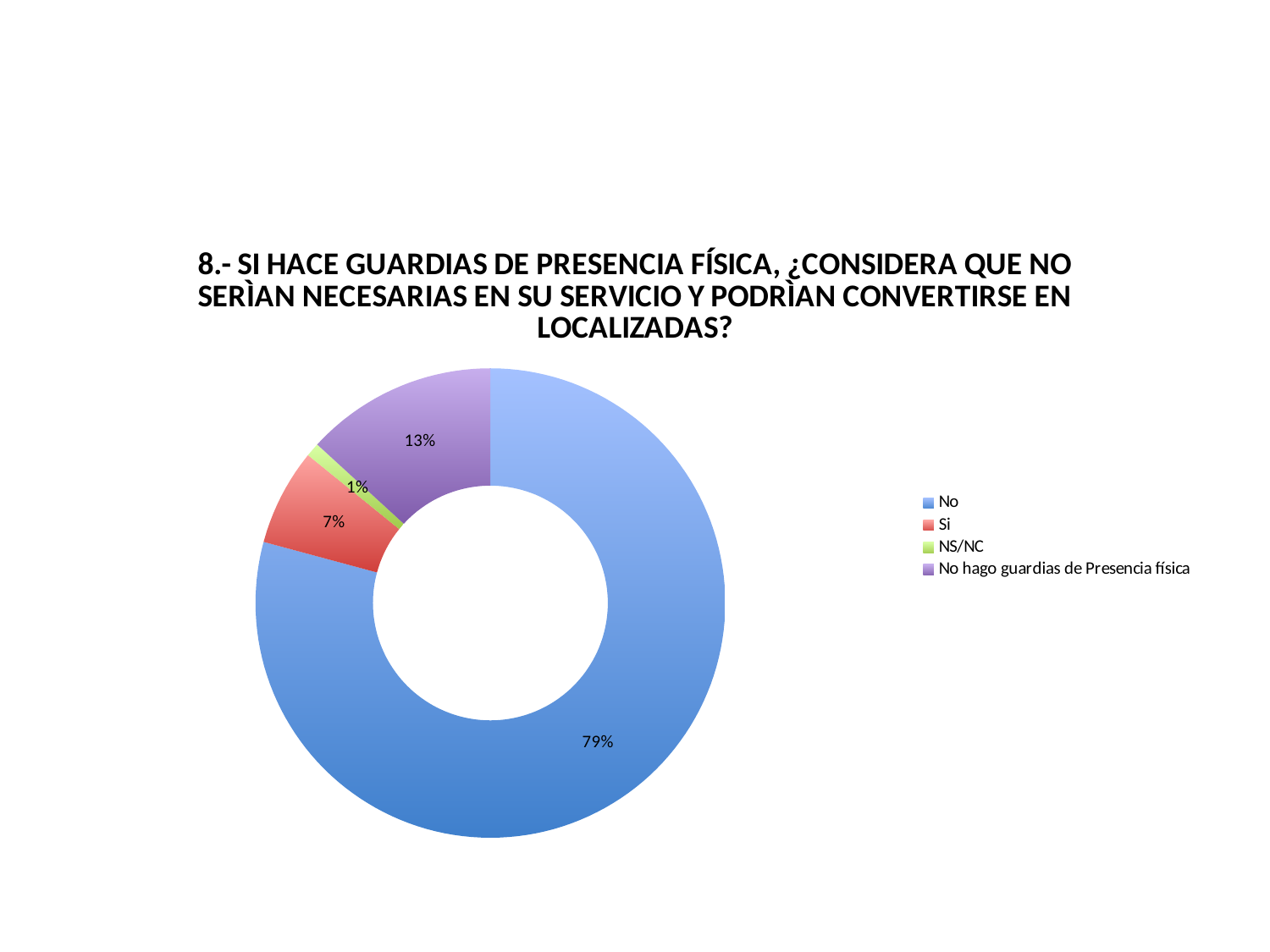
Which category has the largest share of the chart? No Which is larger, the share for "Si" or the share for "No hago guardias de Presencia física"? No hago guardias de Presencia física What kind of chart is shown on the slide? Doughnut (pie) chart Which category has the smallest share of the chart? NS/NC What is the difference in percentage points between "No" and "No hago guardias de Presencia física"? 66 What percentage of responses are "Si"? 7% What percentage of responses are "No hago guardias de Presencia física"? 13% What percentage of responses are "No"? 79% What percentage of responses are "NS/NC"? 1% How many categories does the legend list? 4 What colour represents the "No" category? Blue What is the difference in percentage points between "No hago guardias de Presencia física" and "Si"? 6